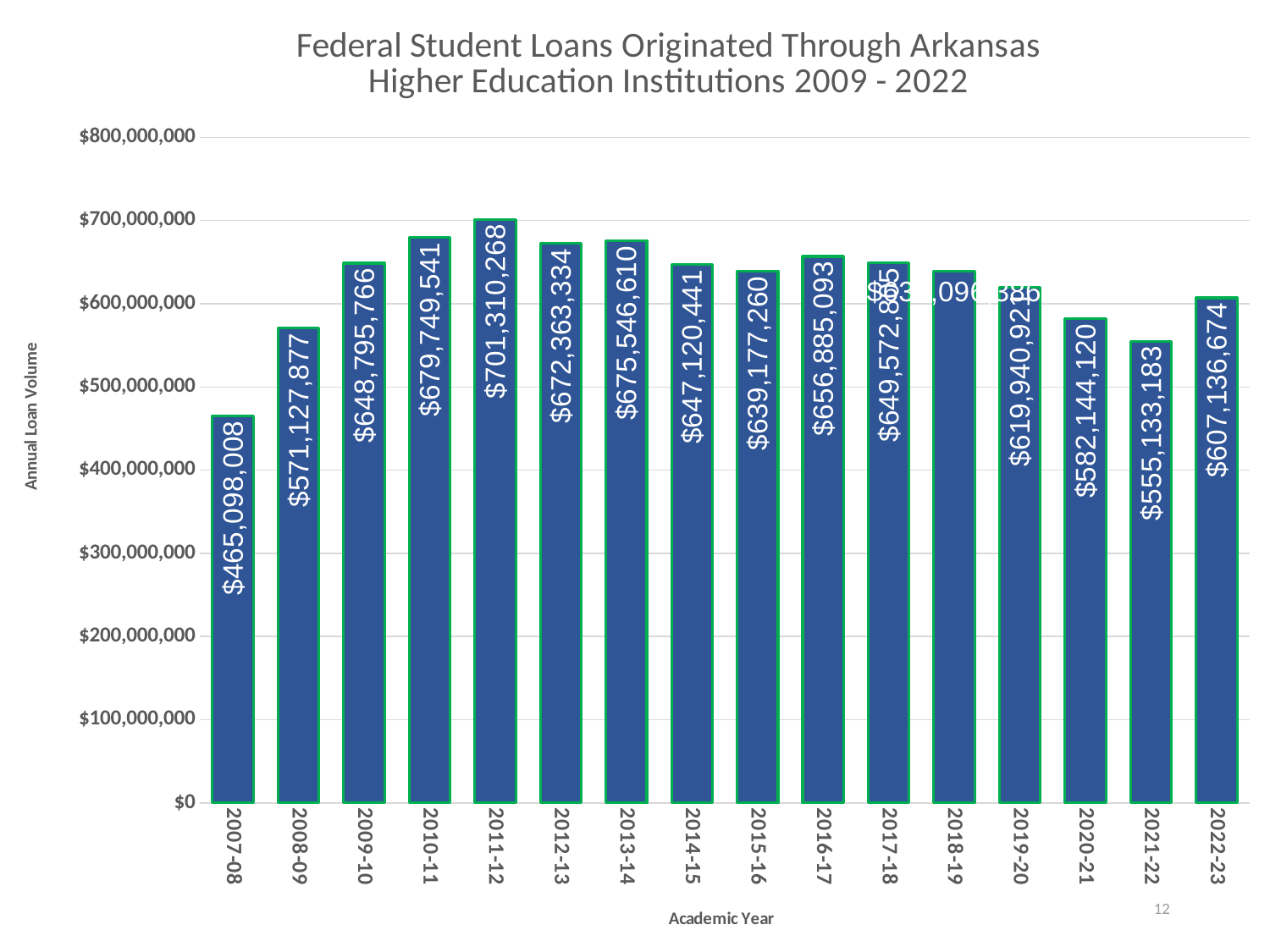
What is the difference between the loan volume in 2011-12 and in 2007-08? $236,212,260 What is the loan volume for 2022-23? $607,136,674 Which has a larger loan volume, 2010-11 or 2013-14? 2010-11 What is the loan volume for 2011-12? $701,310,268 What is the difference between the loan volume in 2022-23 and in 2021-22? $52,003,491 Which academic year has the lowest loan volume? 2007-08 How many academic years are plotted on the chart? 16 Is the value for 2018-19 greater or less than $600,000,000? greater Do the loan volumes rise or fall from 2019-20 to 2021-22? Fall What type of chart is shown on the slide? Bar chart Which academic year has the highest loan volume? 2011-12 What is the loan volume for 2007-08? $465,098,008